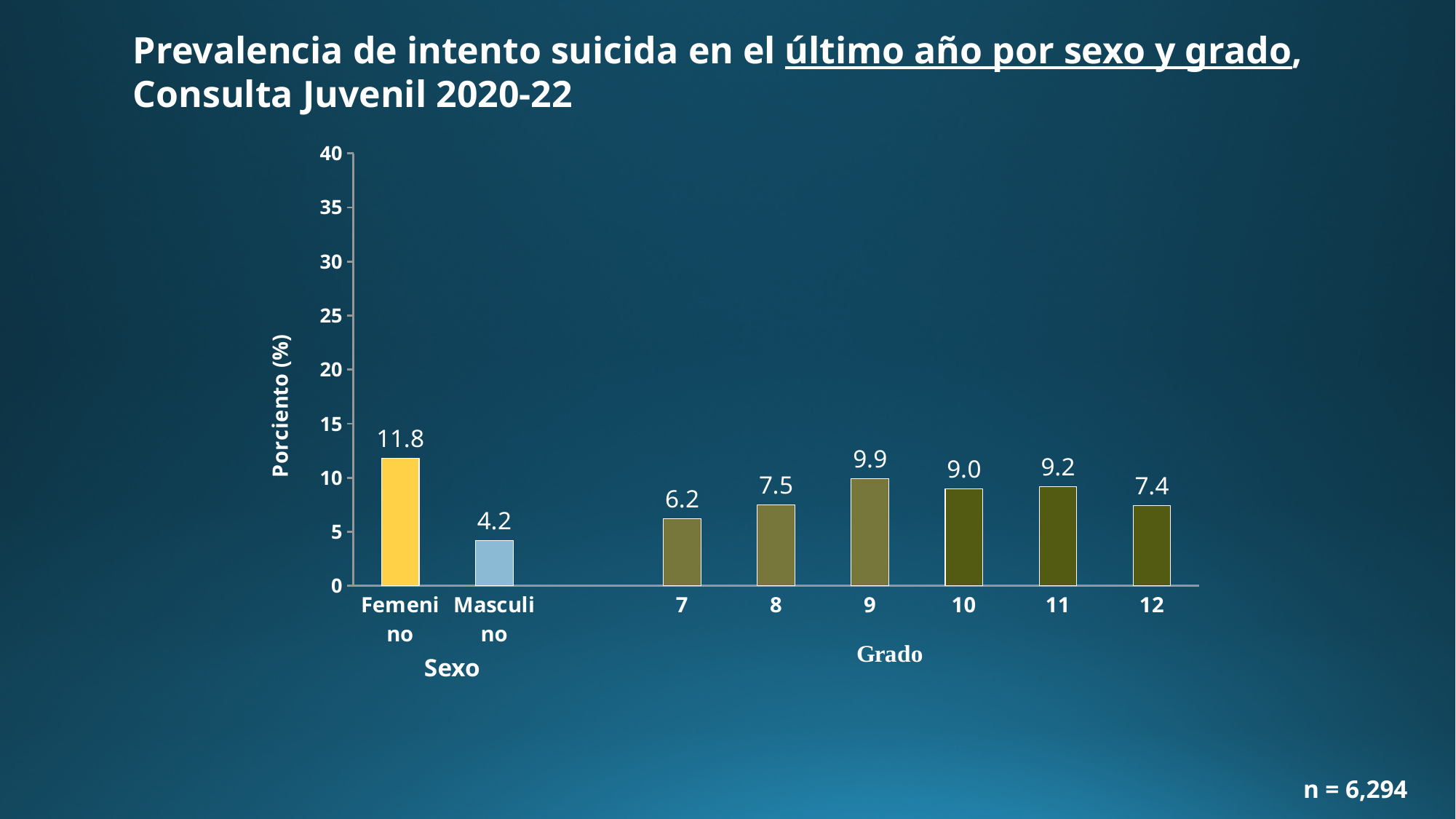
Which grade has the highest value? 9 What is the label of the vertical axis? Porciento (%) What kind of chart is shown on the slide? bar chart What is the value for grade 9? 9.9 What is the value for grade 12? 7.4 What is the value for Masculino? 4.2 Which grade has the lowest value? 7 Which is larger, the value for grade 8 or the value for grade 12? grade 8 What is the difference between the Femenino and Masculino values? 7.6 How many grade categories are shown on the chart? 6 Is the value for Femenino greater or less than 10? greater What is the value for Femenino? 11.8